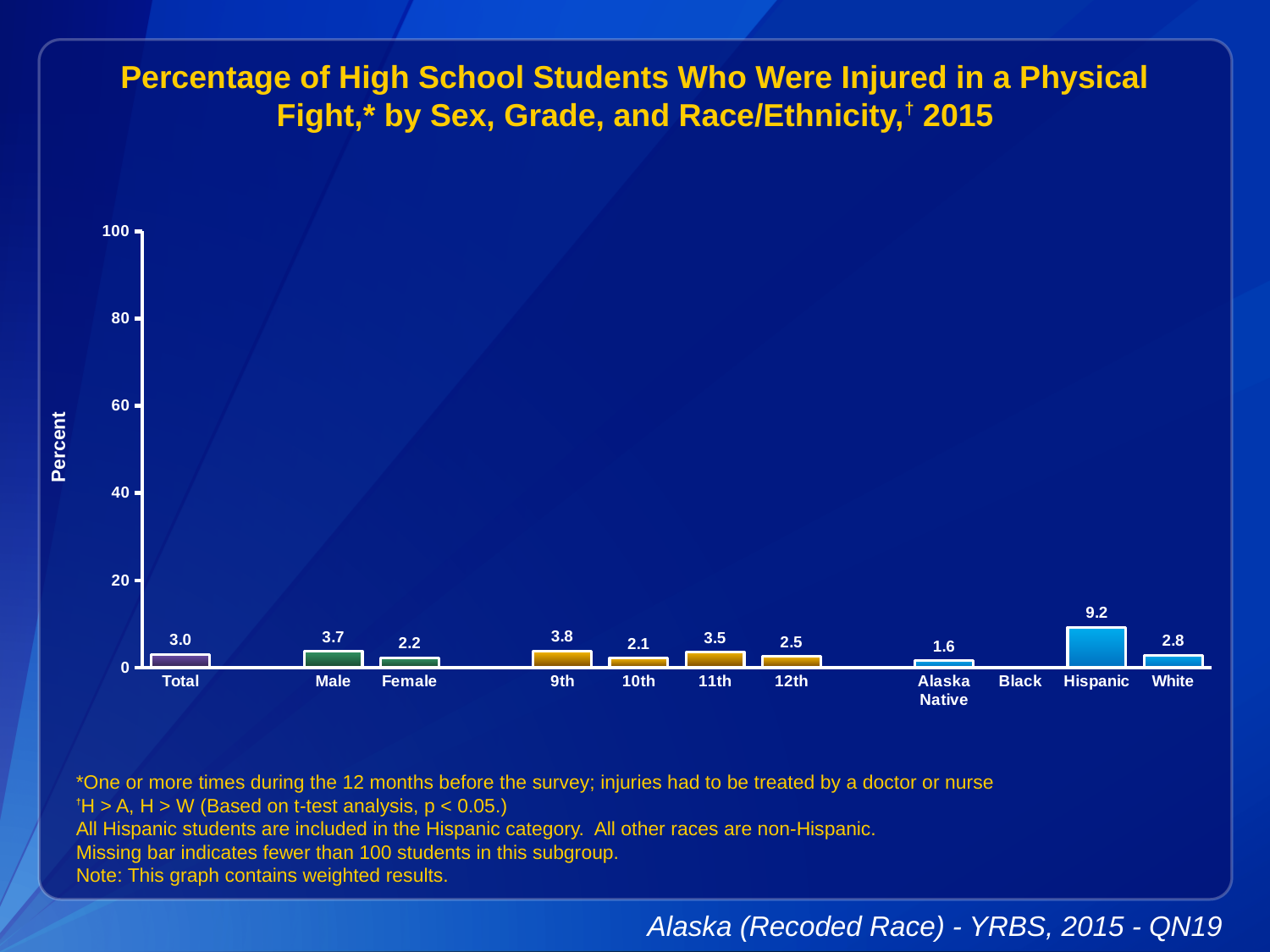
What is the value for 10th grade students? 2.1 What is the label of the y axis? Percent Is the value for Hispanic greater or less than 20? less What is the value for Total? 3.0 Which is larger, the value for 9th grade or the value for 12th grade? 9th Which category has the highest value? Hispanic Which category has no bar shown? Black Which category with a bar has the lowest value? Alaska Native What is the value for Hispanic students? 9.2 What is the difference between the values for Male and Female? 1.5 What kind of chart is shown? bar chart How many categories are labeled on the x axis? 11